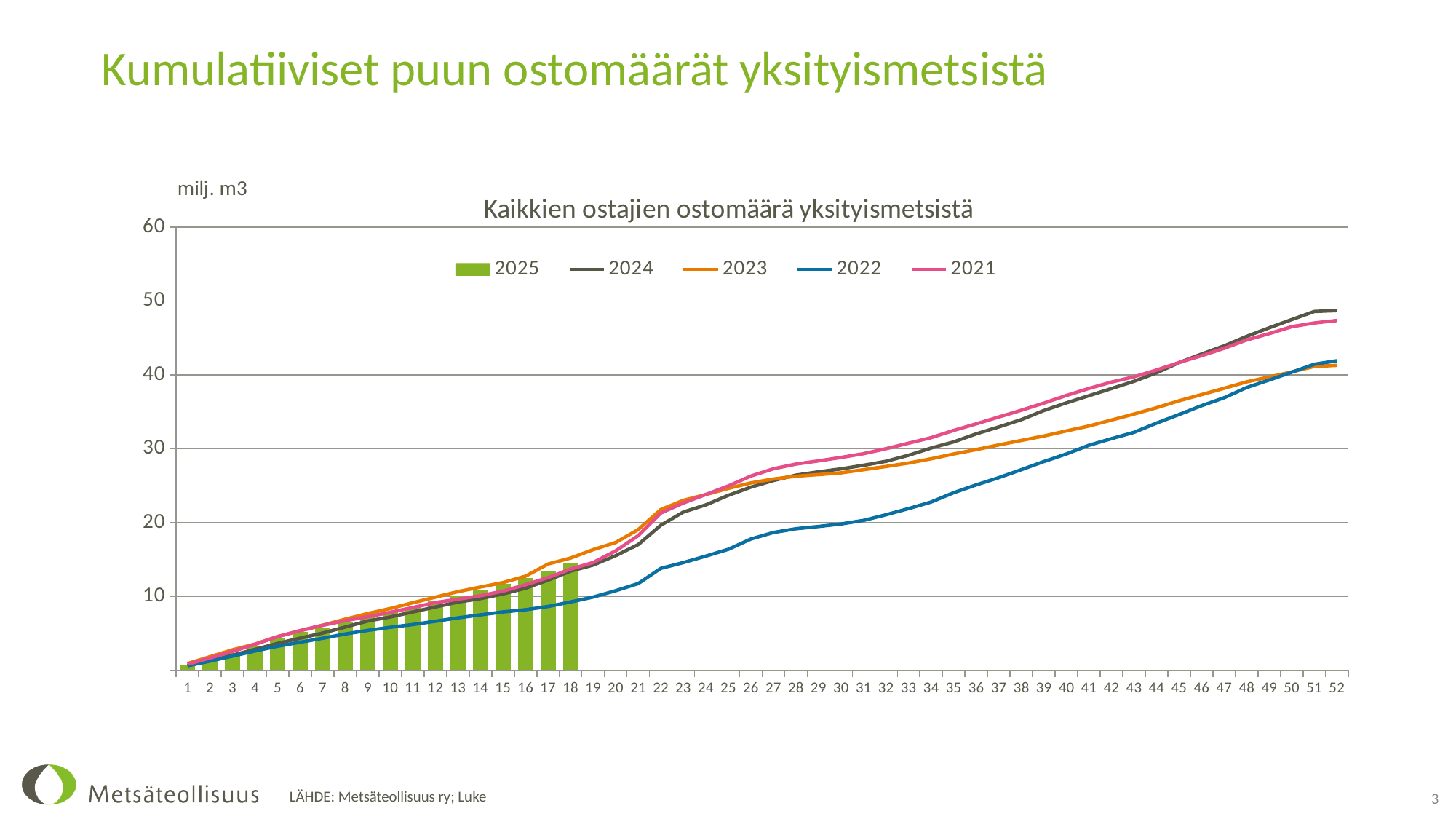
How many series does the legend list? 5 Which series is shown as bars rather than a line? 2025 What kind of chart is this? Combined bar and line chart At week 30, which is larger: the 2021 line or the 2022 line? 2021 Do the values of the 2024 line rise or fall along the x axis? Rise Is the value of the 2024 line at week 52 greater or less than 40? greater Is the 2025 bar at week 18 greater or less than 10? greater Which series has the highest value at week 52? 2024 Is the value of the 2022 line at week 26 greater or less than 20? less What unit is shown on the y axis? milj. m3 How many weeks are labelled on the x axis? 52 Up to which week are bars plotted for the 2025 series? 18